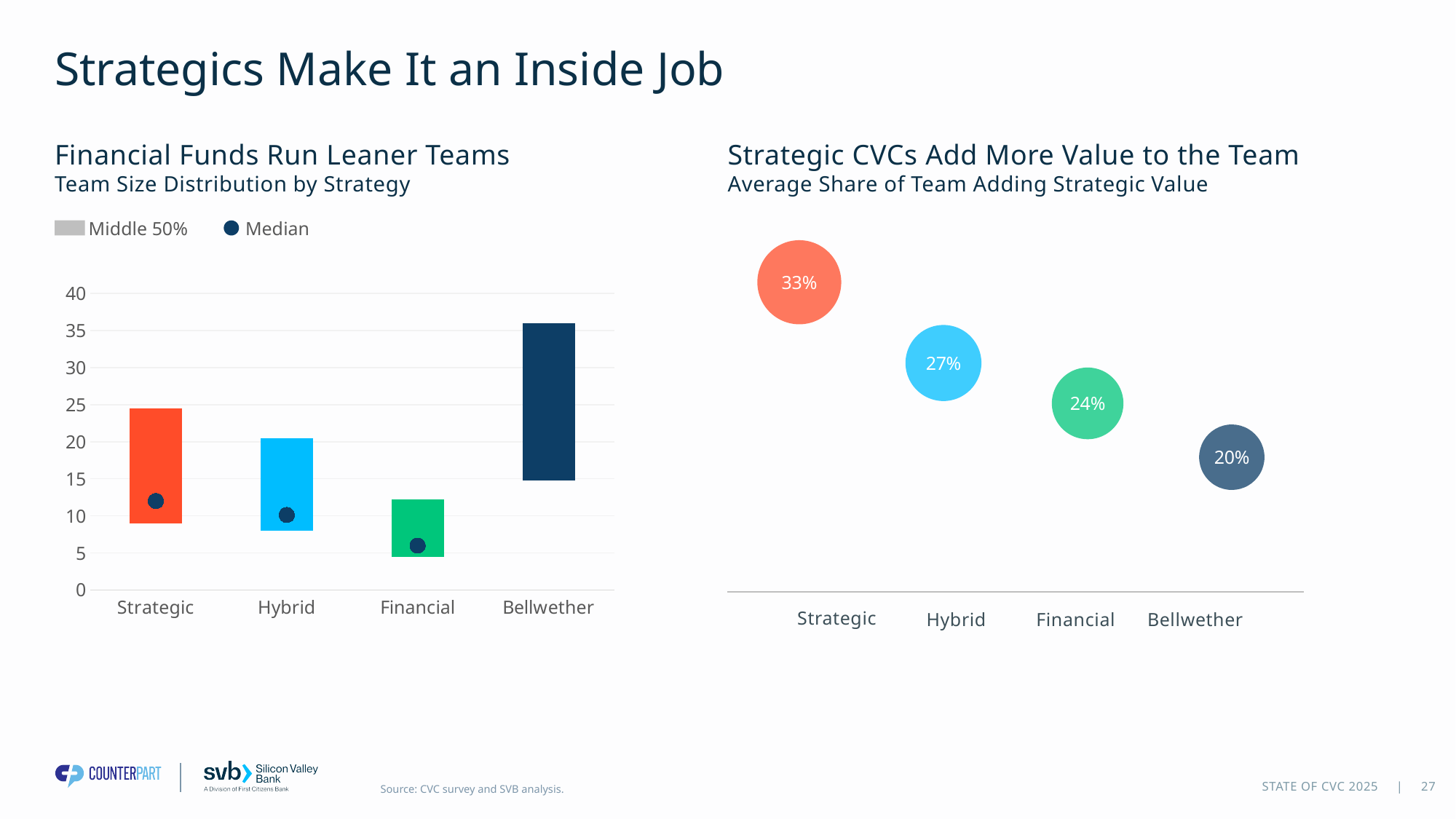
In the chart titled 'Strategic CVCs Add More Value to the Team', which category has the highest value? Strategic In the chart titled 'Financial Funds Run Leaner Teams', how many categories are shown on the x axis? 4 In the chart titled 'Financial Funds Run Leaner Teams', is the median for Financial greater or less than 10? less In the chart titled 'Strategic CVCs Add More Value to the Team', which is larger, the value for Hybrid or the value for Financial? Hybrid In the chart titled 'Strategic CVCs Add More Value to the Team', which category has the lowest value? Bellwether In the chart titled 'Financial Funds Run Leaner Teams', is the top of the Bellwether bar greater or less than 30? greater In the chart titled 'Strategic CVCs Add More Value to the Team', what is the average share of team adding strategic value for Strategic? 33% In the chart titled 'Financial Funds Run Leaner Teams', which category's bar reaches the highest value on the y axis? Bellwether In the chart titled 'Strategic CVCs Add More Value to the Team', what is the difference between the Strategic and Bellwether values? 13 percentage points In the chart titled 'Strategic CVCs Add More Value to the Team', what is the value for Bellwether? 20% In the chart titled 'Strategic CVCs Add More Value to the Team', do the values rise or fall from left to right across the categories? fall In the chart titled 'Financial Funds Run Leaner Teams', how many series does the legend list? 2